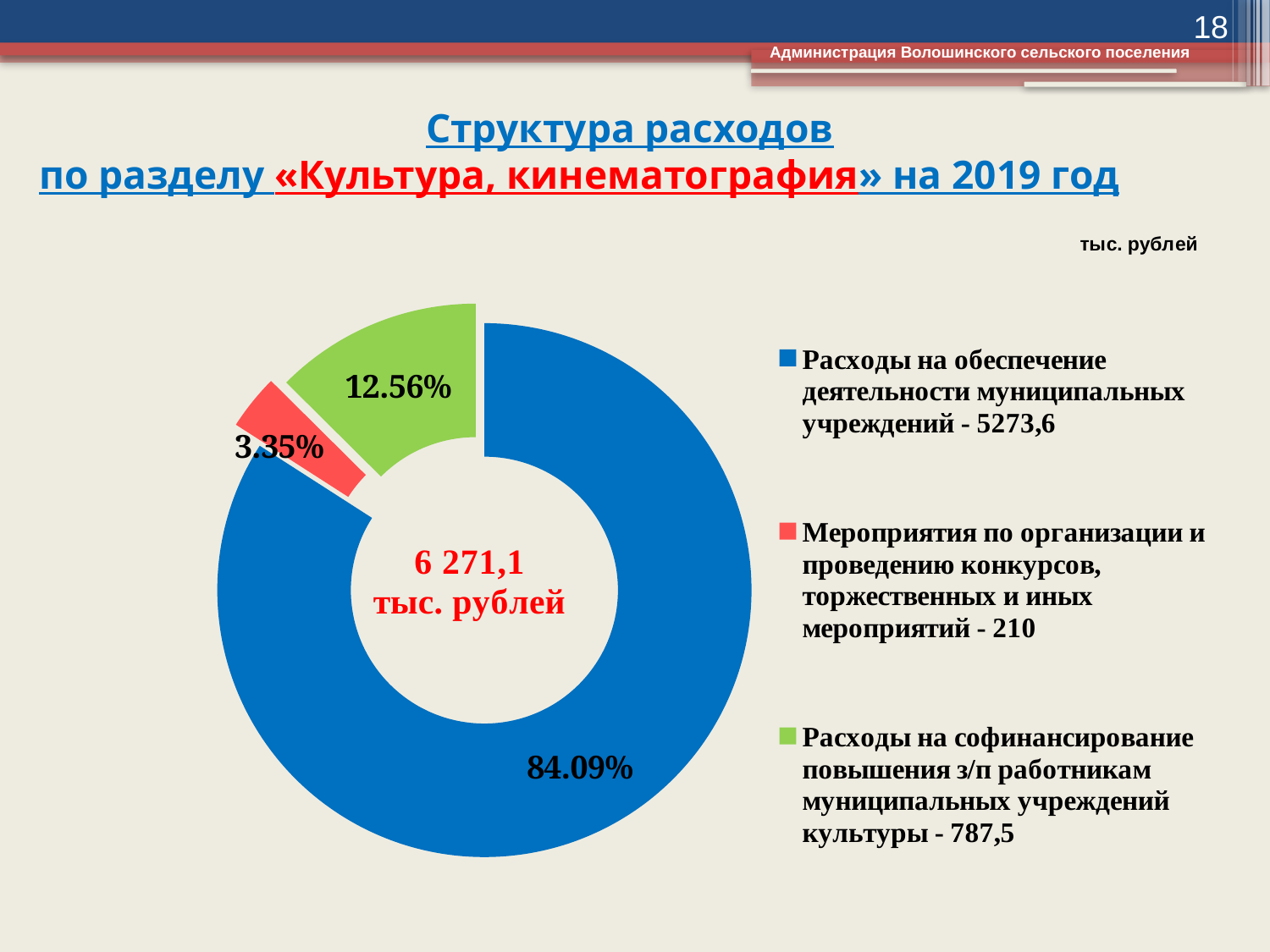
What is the total amount shown in the centre of the chart? 6 271,1 тыс. рублей What share of the chart does the slice for «Мероприятия по организации и проведению конкурсов, торжественных и иных мероприятий» represent? 3.35% Which category has the smallest share of the chart? Мероприятия по организации и проведению конкурсов, торжественных и иных мероприятий What is the value (тыс. рублей) shown in the legend for «Расходы на софинансирование повышения з/п работникам муниципальных учреждений культуры»? 787,5 What is the value (тыс. рублей) shown in the legend for «Мероприятия по организации и проведению конкурсов, торжественных и иных мероприятий»? 210 What kind of chart is shown on the slide? doughnut (pie) chart How many categories does the chart show? 3 What share of the chart does the slice for «Расходы на обеспечение деятельности муниципальных учреждений» represent? 84.09% Which category has the largest share of the chart? Расходы на обеспечение деятельности муниципальных учреждений What share of the chart does the slice for «Расходы на софинансирование повышения з/п работникам муниципальных учреждений культуры» represent? 12.56% What is the difference in percentage points between the largest slice (84.09%) and the green slice (12.56%)? 71.53 What is the value (тыс. рублей) shown in the legend for «Расходы на обеспечение деятельности муниципальных учреждений»? 5273,6